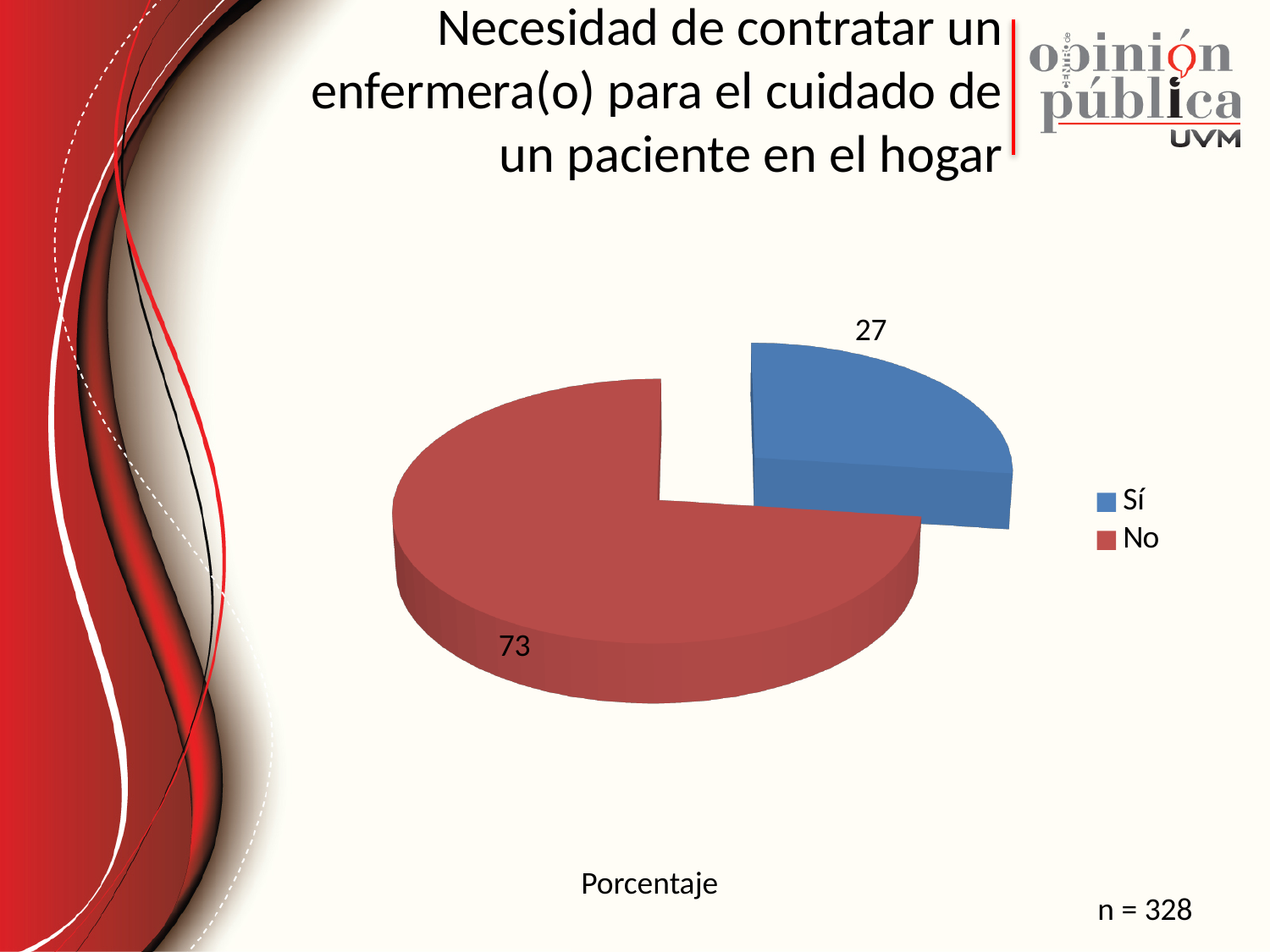
How many categories does the pie chart show? 2 Which is larger, the value for "Sí" or the value for "No"? No What value is shown for the "Sí" slice? 27 What value is shown for the "No" slice? 73 What colour is the "No" slice in the pie chart? Red Which category has the largest slice of the pie? No What kind of chart is shown on the slide? Pie chart How many entries does the legend list? 2 Which category has the smallest slice of the pie? Sí What is the difference between the values for "No" and "Sí"? 46 What is the sample size (n) stated on the slide? 328 What is the total of the two slice values shown? 100